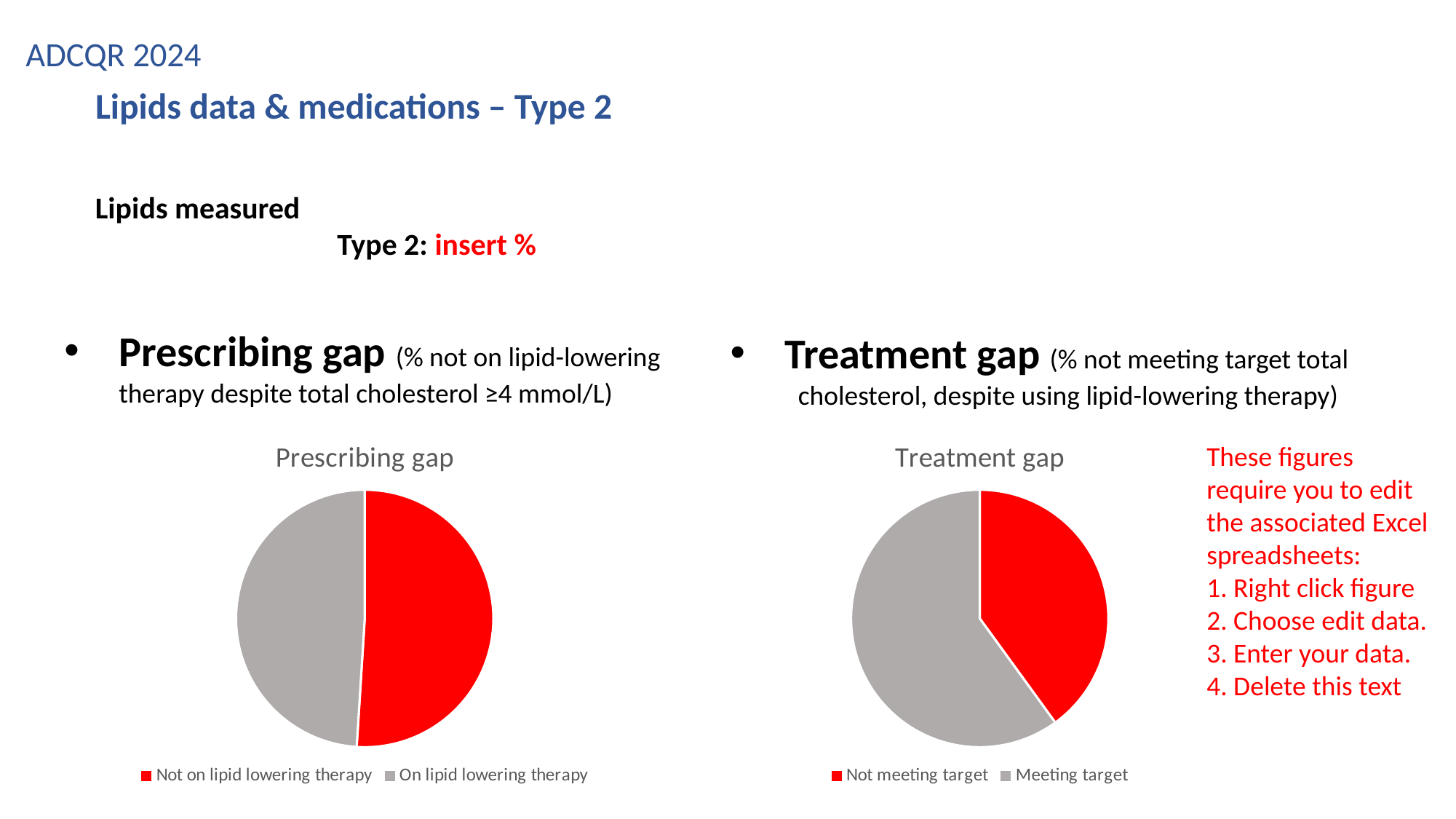
How many entries does the legend of the "Treatment gap" chart list? 2 What kind of chart is the "Prescribing gap" chart? pie chart How many slices does the "Prescribing gap" pie chart have? 2 How many slices does the "Treatment gap" pie chart have? 2 What is the title of the pie chart on the right side of the slide? Treatment gap What colour is the "Not on lipid lowering therapy" slice in the "Prescribing gap" chart? red In the "Treatment gap" pie chart, which slice is larger: "Not meeting target" or "Meeting target"? Meeting target What kind of chart is the "Treatment gap" chart? pie chart How many entries does the legend of the "Prescribing gap" chart list? 2 In the "Treatment gap" pie chart, which category has the largest slice? Meeting target In the "Treatment gap" pie chart, which category has the smallest slice? Not meeting target